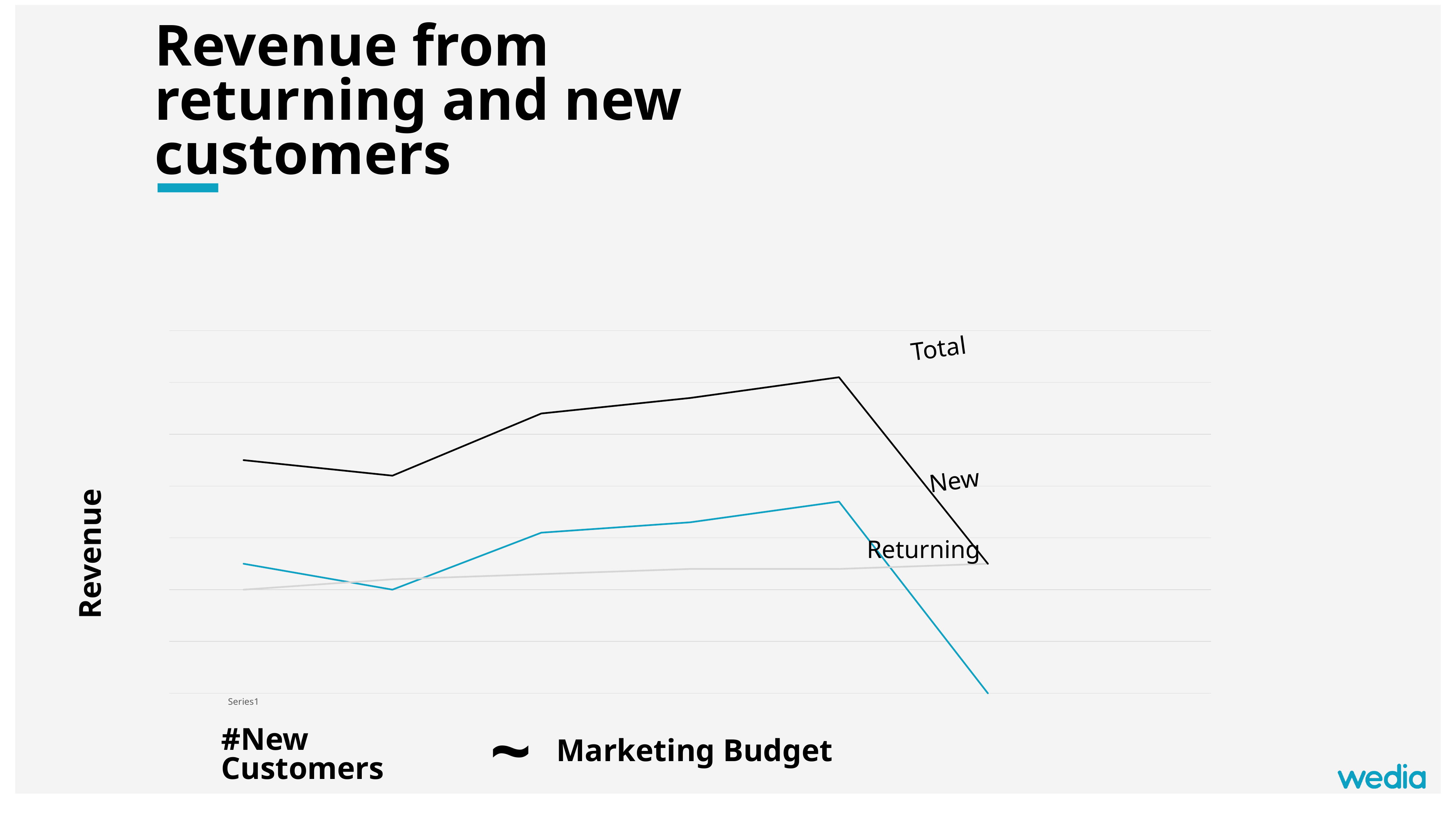
At the last (rightmost) point, which is higher, the Returning line or the New line? Returning How many lines (series) are plotted on the chart? 3 Which line is the lowest at the last (rightmost) point? New At the first (leftmost) point, which is higher, the New line or the Returning line? New Does the New line rise or fall between its fifth and sixth points? falls What is the label on the vertical axis of the chart? Revenue Does the Returning line rise or fall along the x axis? rises What kind of chart is shown on the slide? line chart Which line is the highest across the chart? Total Does the Total line rise or fall between its second and fifth points? rises How many data points does each line on the chart have? 6 What are the names of the three lines plotted on the chart? Total, New, Returning